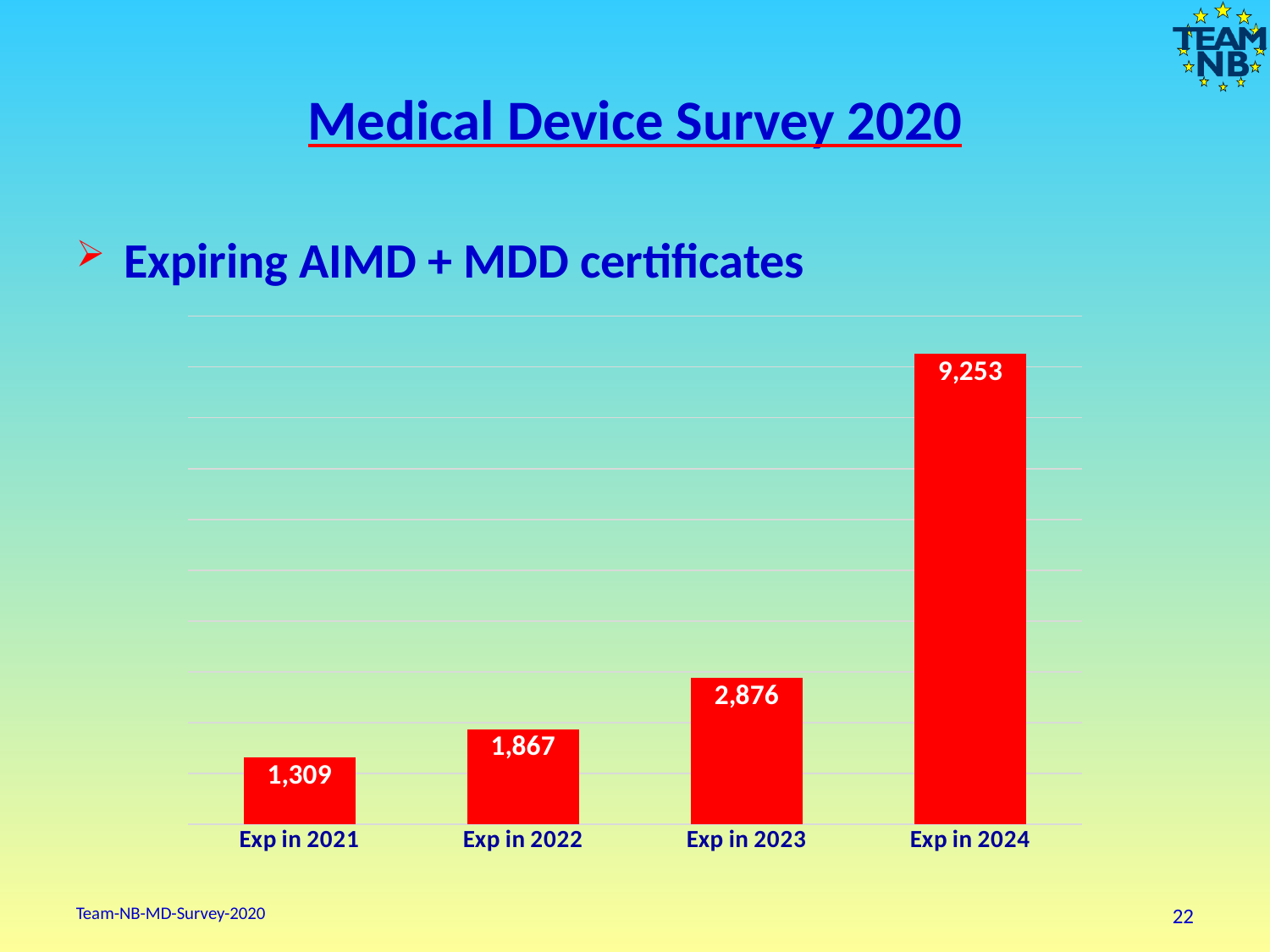
Do the values rise or fall from Exp in 2021 to Exp in 2024? Rise Which category has the highest value? Exp in 2024 What is the difference between the values for Exp in 2024 and Exp in 2023? 6,377 What kind of chart is shown on the slide? Bar chart What is the value for Exp in 2023? 2,876 What is the difference between the values for Exp in 2022 and Exp in 2021? 558 What is the value for Exp in 2022? 1,867 What is the value for Exp in 2021? 1,309 What is the value for Exp in 2024? 9,253 Which is larger, the value for Exp in 2023 or the value for Exp in 2022? Exp in 2023 Which category has the lowest value? Exp in 2021 How many categories are shown in the chart? 4